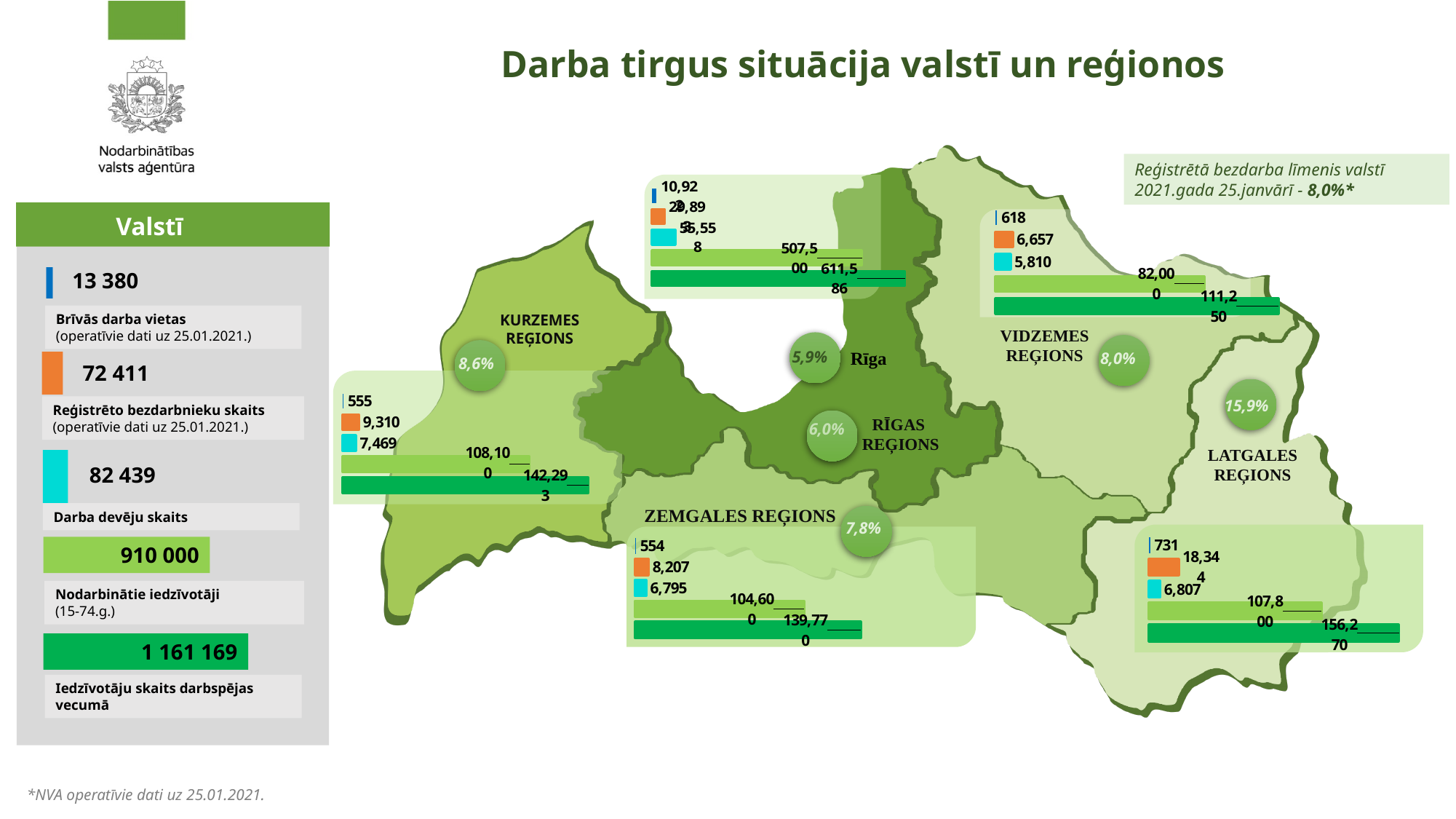
What is the difference between the vacancies value for Latgales reģions (731) and Kurzemes reģions (555)? 176 Which of the circled unemployment rates on the map is the lowest? Rīga (5,9%) What kind of chart is used for each region on the map? Bar chart On the Zemgales reģions chart, what is the value of the orange bar (registered unemployed)? 8,207 Which region's circle shows the highest registered unemployment rate? Latgales reģions On the Kurzemes reģions chart, what is the value of the cyan bar (employers)? 7,469 On the Kurzemes reģions chart, what is the value of the orange bar (registered unemployed)? 9,310 What registered unemployment rate is shown in the circle for Latgales reģions? 15,9% Which is larger: the registered unemployed value for Kurzemes reģions or for Zemgales reģions? Kurzemes reģions On the Vidzemes reģions chart, what is the value of the blue bar (vacancies)? 618 On the Latgales reģions chart, what is the value of the cyan bar (employers)? 6,807 In the 'Valstī' panel on the left, what is the value for Reģistrēto bezdarbnieku skaits? 72 411